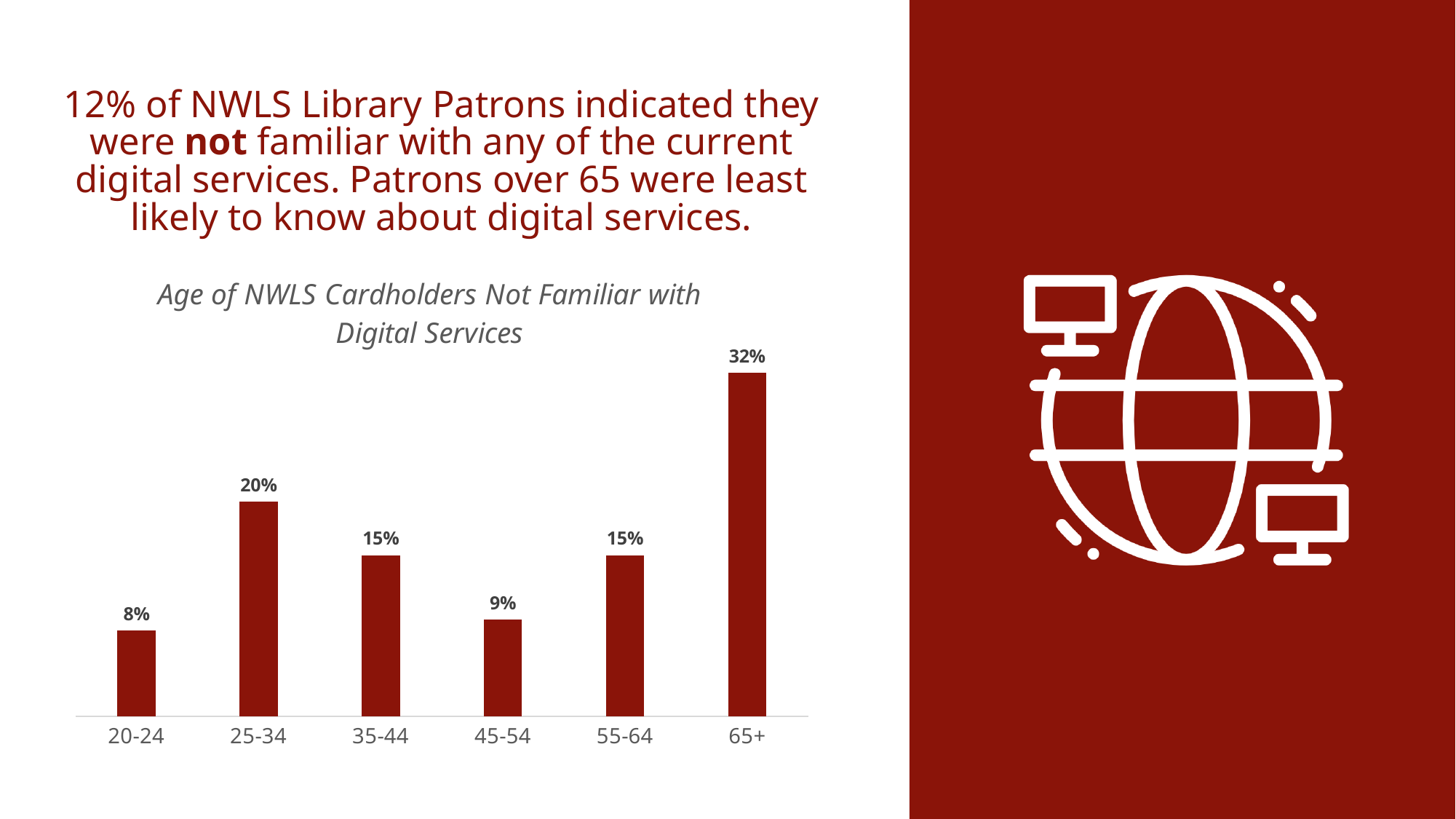
What is the value shown for the 45-54 age group? 9% What kind of chart is shown on the slide? Bar chart What is the title of the chart? Age of NWLS Cardholders Not Familiar with Digital Services Which two age groups share the same value of 15%? 35-44 and 55-64 How many age groups are shown in the chart? 6 What is the difference between the values for the 65+ and 25-34 age groups? 12% Which age group has the lowest value in the chart? 20-24 What is the difference between the values for the 45-54 and 20-24 age groups? 1% Which age group has the highest value in the chart? 65+ Which age group has a larger value, 25-34 or 35-44? 25-34 What is the value shown for the 20-24 age group? 8% What percentage of NWLS cardholders not familiar with digital services are aged 65+? 32%